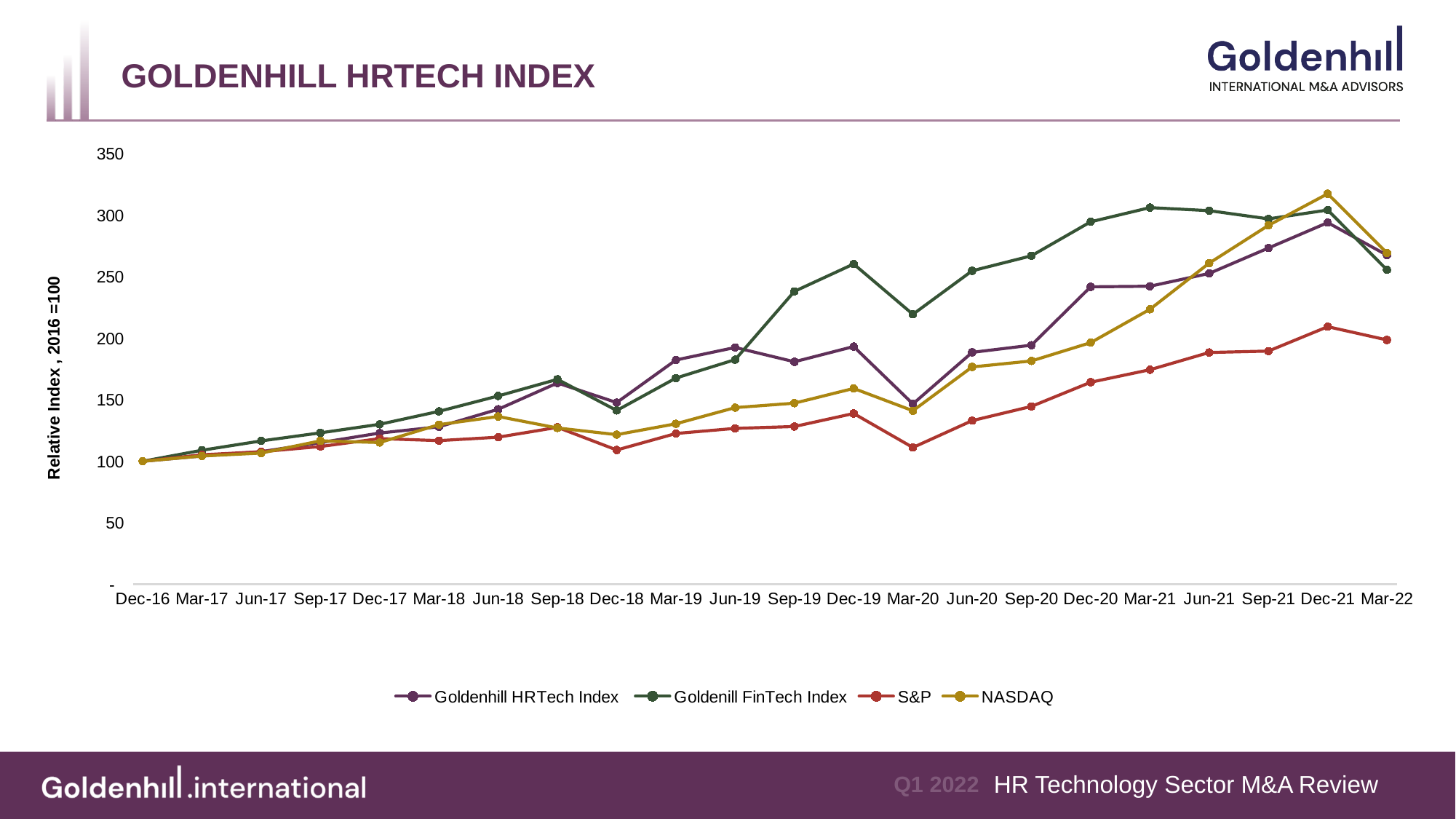
How many series does the legend list? 4 What kind of chart is shown on the slide? line chart Which series has the lowest value at Mar-22? S&P Is the value for the Goldenill FinTech Index at Sep-19 greater or less than 200? greater Which series has the highest value at Dec-19? Goldenill FinTech Index Is the value for S&P at Dec-18 greater or less than 150? less How many time points are plotted along the x axis? 22 At Dec-20, which is larger: NASDAQ or S&P? NASDAQ Which series has the highest value at Dec-21? NASDAQ Does the S&P series generally rise or fall from Dec-16 to Mar-22? rise Is the value for NASDAQ at Dec-21 greater or less than 300? greater What is the label on the y axis? Relative Index , 2016 =100